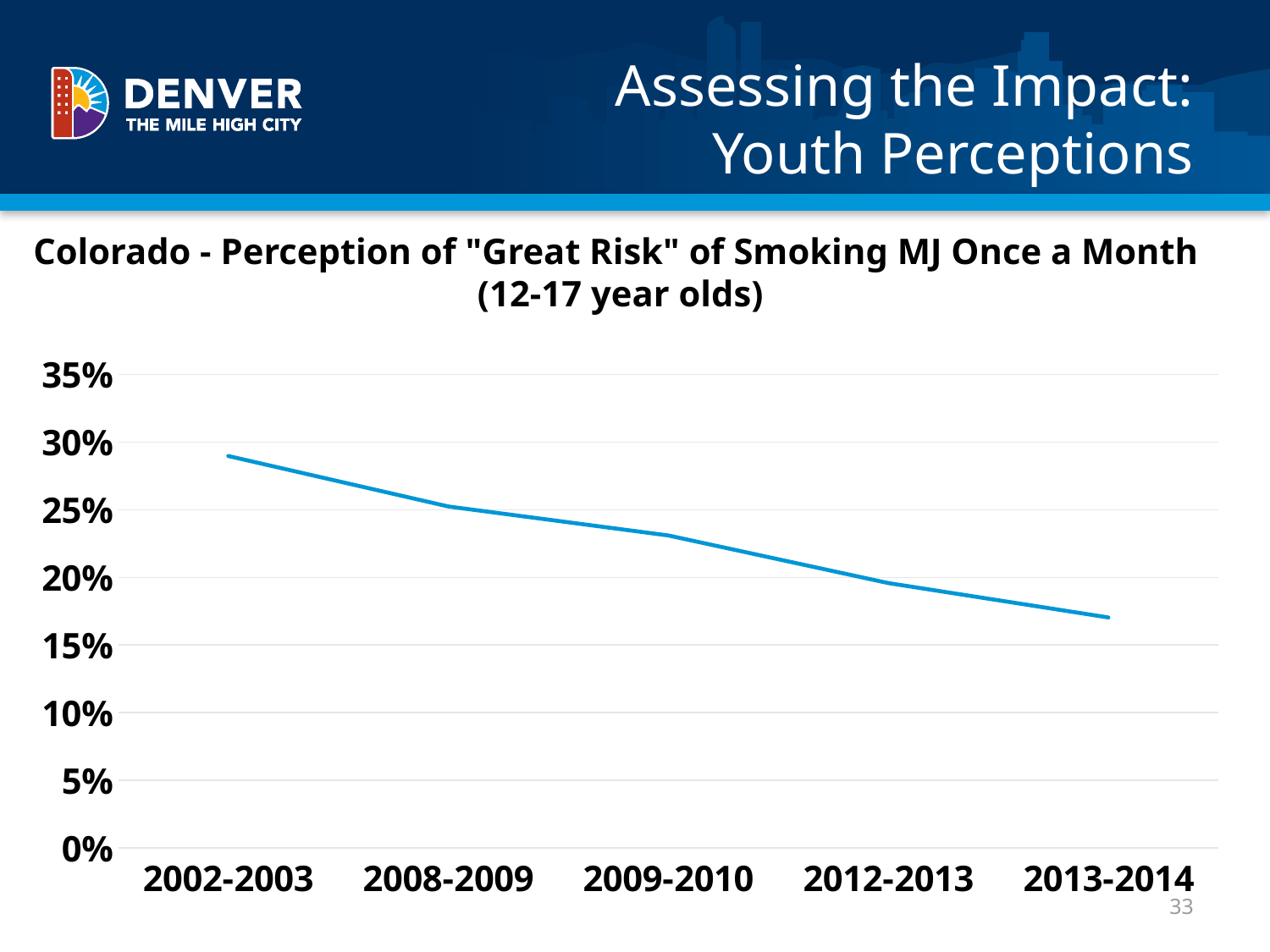
How many time periods are plotted along the x axis? 5 What age group does the chart title say the data covers? 12-17 year olds Which period has the lowest perception of "great risk"? 2013-2014 Is the value for 2012-2013 greater or less than 15%? greater Is the value for 2002-2003 greater or less than 25%? greater Is the value for 2013-2014 greater or less than 20%? less Which period has the highest perception of "great risk"? 2002-2003 Which is larger, the value for 2002-2003 or the value for 2013-2014? 2002-2003 Do the values rise or fall from 2002-2003 to 2013-2014? fall Which is larger, the value for 2008-2009 or the value for 2012-2013? 2008-2009 What kind of chart is shown on the slide? line chart